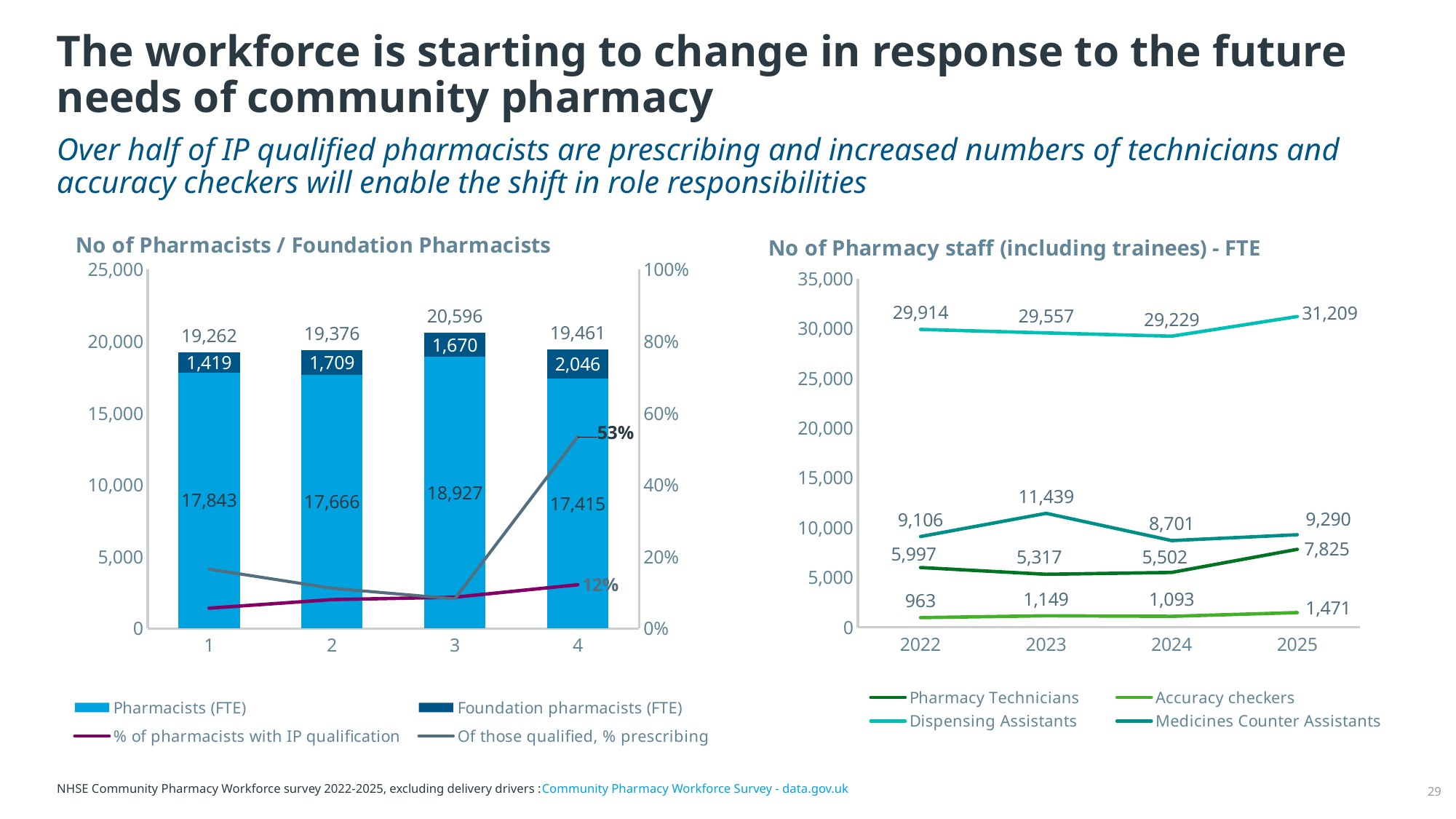
In the 'No of Pharmacy staff (including trainees) - FTE' chart, what is the Medicines Counter Assistants value for 2023? 11,439 In the 'No of Pharmacists / Foundation Pharmacists' chart, what is the Pharmacists (FTE) value for category 3? 18,927 In the 'No of Pharmacists / Foundation Pharmacists' chart, which category has the highest Foundation pharmacists (FTE) value? 4 In the 'No of Pharmacy staff (including trainees) - FTE' chart, what is the difference between the Pharmacy Technicians values for 2025 and 2024? 2,323 In the 'No of Pharmacists / Foundation Pharmacists' chart, how many series does the legend list? 4 In the 'No of Pharmacists / Foundation Pharmacists' chart, what is the Foundation pharmacists (FTE) value for category 4? 2,046 What kind of chart is 'No of Pharmacy staff (including trainees) - FTE'? Line chart In the 'No of Pharmacy staff (including trainees) - FTE' chart, which is larger in 2024: Medicines Counter Assistants or Pharmacy Technicians? Medicines Counter Assistants In the 'No of Pharmacists / Foundation Pharmacists' chart, what is the final value shown for 'Of those qualified, % prescribing'? 53% In the 'No of Pharmacy staff (including trainees) - FTE' chart, which year has the lowest Accuracy checkers value? 2022 In the 'No of Pharmacists / Foundation Pharmacists' chart, what is the total of the stacked bar for category 2? 19,376 In the 'No of Pharmacy staff (including trainees) - FTE' chart, what is the Dispensing Assistants value for 2025? 31,209